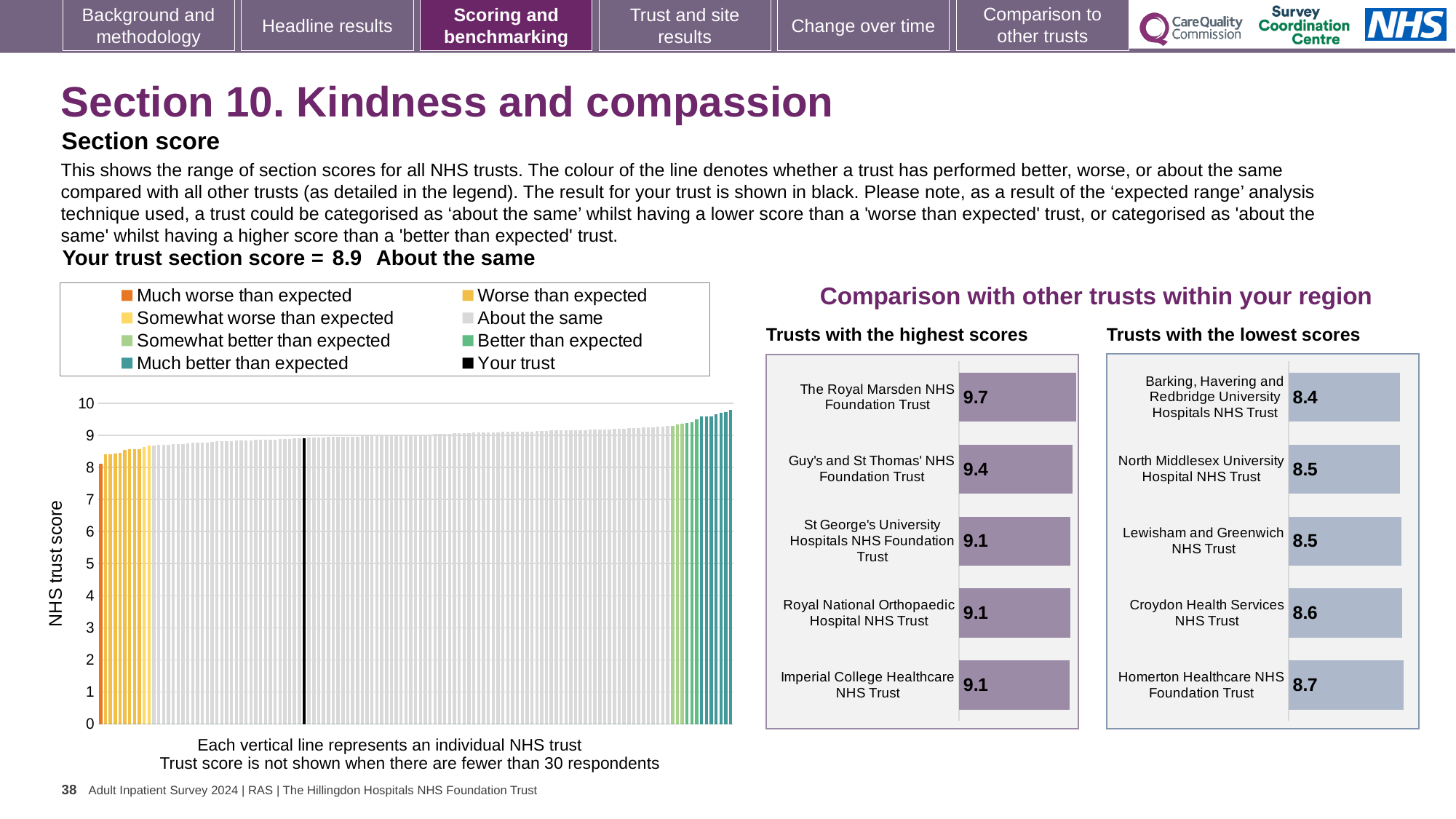
In the 'Trusts with the highest scores' chart, what is the score for The Royal Marsden NHS Foundation Trust? 9.7 What kind of chart is the main 'NHS trust score' chart on the left? Bar chart How many entries does the legend of the main 'NHS trust score' chart list? 8 In the 'Trusts with the highest scores' chart, what is the difference between the scores of The Royal Marsden NHS Foundation Trust and Guy's and St Thomas' NHS Foundation Trust? 0.3 How many trusts are shown in the 'Trusts with the highest scores' chart? 5 In the 'Trusts with the lowest scores' chart, what is the difference between the scores of Homerton Healthcare NHS Foundation Trust and Barking, Havering and Redbridge University Hospitals NHS Trust? 0.3 In the 'Trusts with the lowest scores' chart, which trust has the highest score? Homerton Healthcare NHS Foundation Trust In the 'Trusts with the lowest scores' chart, which has the larger score: North Middlesex University Hospital NHS Trust or Homerton Healthcare NHS Foundation Trust? Homerton Healthcare NHS Foundation Trust In the 'Trusts with the lowest scores' chart, which trust has the lowest score? Barking, Havering and Redbridge University Hospitals NHS Trust In the main 'NHS trust score' chart, do the values rise or fall from left to right along the x axis? Rise In the 'Trusts with the highest scores' chart, what is the score for Guy's and St Thomas' NHS Foundation Trust? 9.4 In the 'Trusts with the lowest scores' chart, what is the score for Croydon Health Services NHS Trust? 8.6